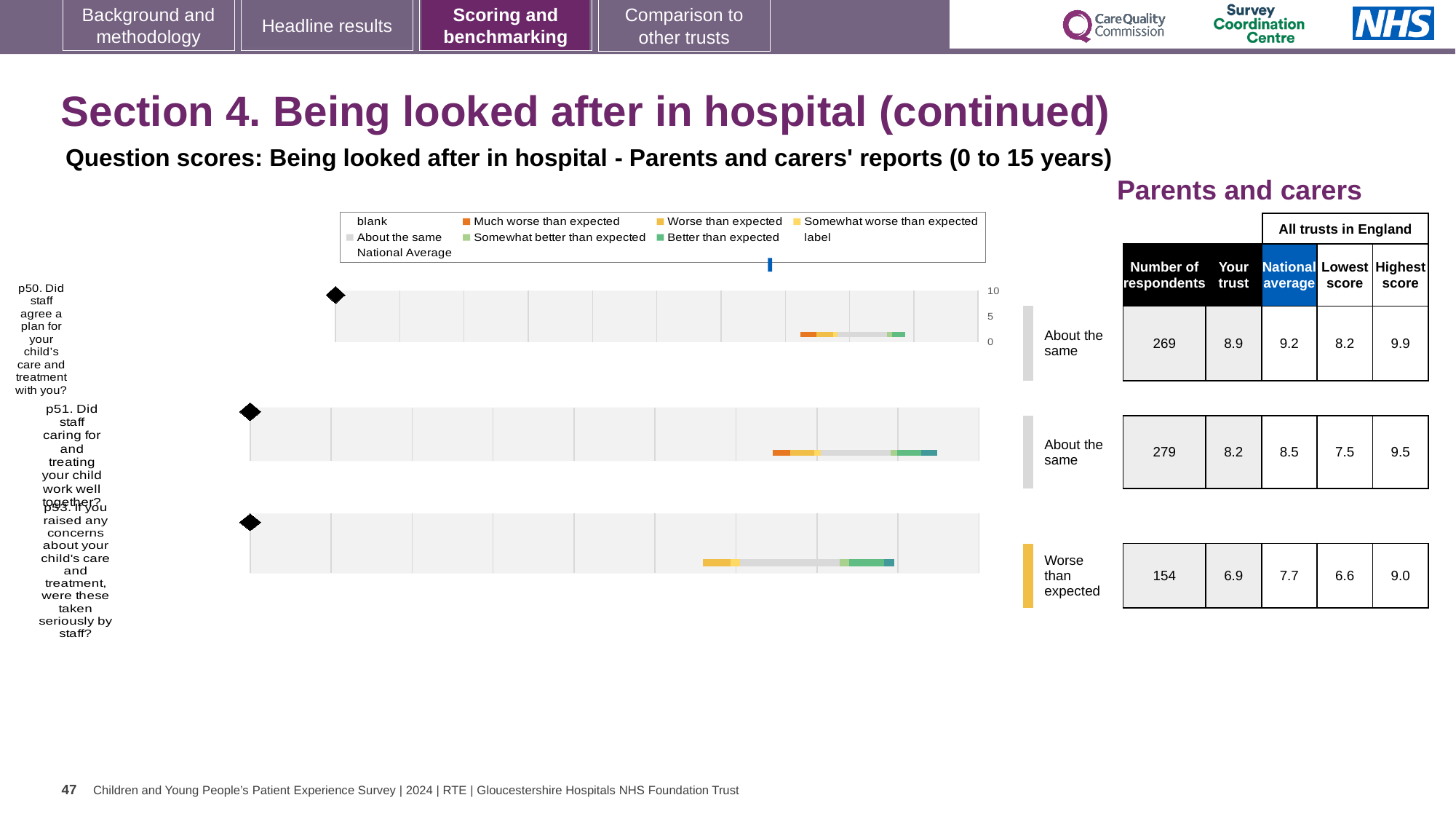
Which of the three questions has the lowest 'Your trust' score? p53 How many survey questions are charted on this slide? 3 What kind of chart is used to show the question scores on this slide? Bar chart For question p50, which is larger: the 'Your trust' score or the national average? National average What is the highest score among all trusts in England for question p50? 9.9 What benchmark category is shown for question p53? Worse than expected How many respondents are shown for question p50 (Did staff agree a plan for your child's care and treatment with you)? 269 For question p53, what is the difference between the national average and the 'Your trust' score? 0.8 Which of the three questions has the highest number of respondents? p51 What is the national average score for question p53 (If you raised any concerns about your child's care and treatment, were these taken seriously by staff)? 7.7 What is the lowest score among all trusts in England for question p51? 7.5 What is the 'Your trust' score for question p51 (Did staff caring for and treating your child work well together)? 8.2